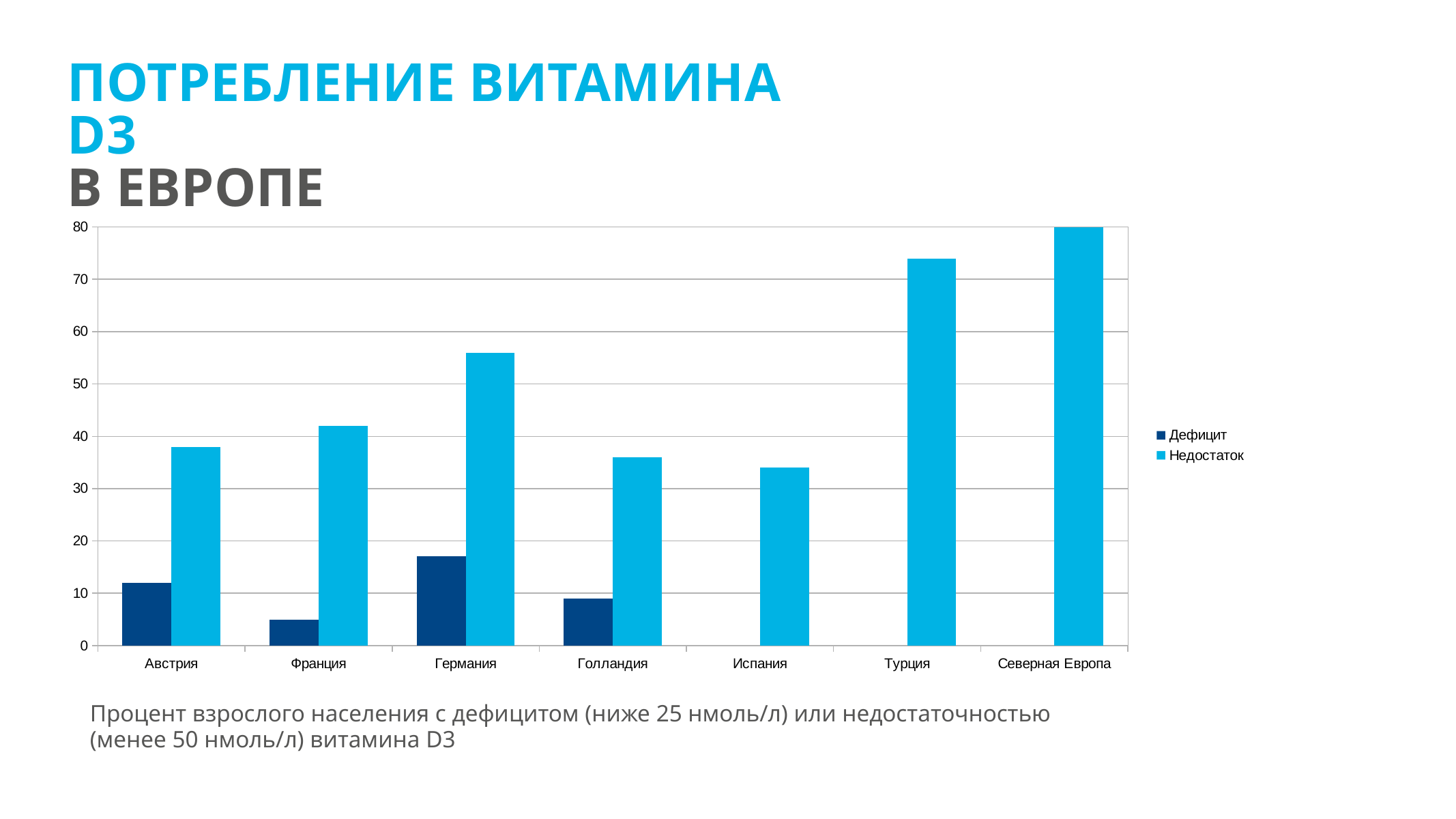
What are the two series named in the chart legend? Дефицит and Недостаток What kind of chart is shown on the slide? bar chart Is the Недостаток value for Германия greater or less than 50? greater Which category has the highest Дефицит value? Германия How many series does the chart legend list? 2 What is the value of Недостаток for Северная Европа? 80 Which category has the highest Недостаток value? Северная Европа Is the Дефицит value for Франция greater or less than 10? less How many countries/regions are shown on the x axis of the chart? 7 Is the Недостаток value for Испания greater or less than 40? less Which is larger, the Недостаток value for Германия or for Франция? Германия